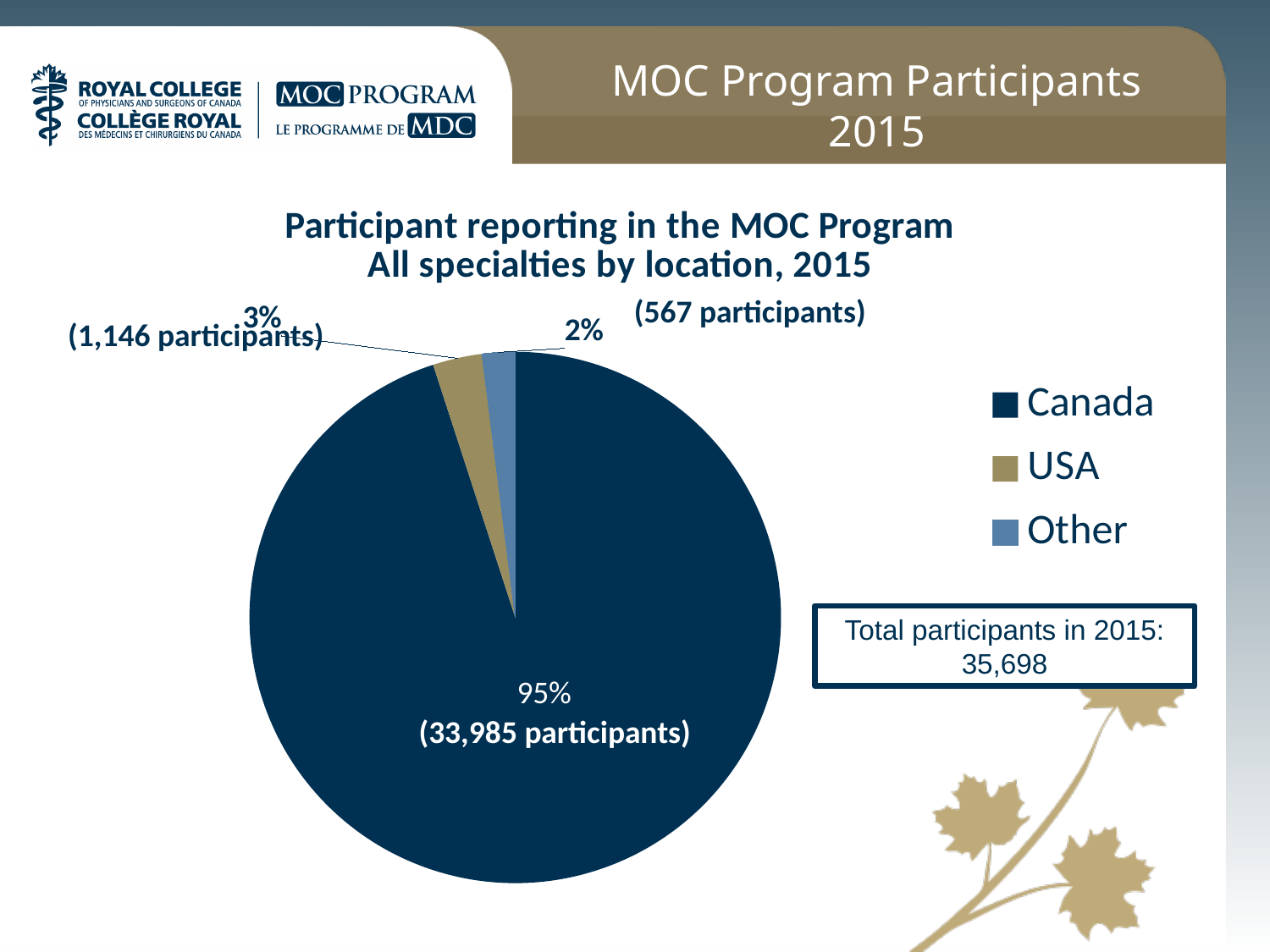
How many participants are reported for Canada? 33,985 participants How many participants are reported for Other? 567 participants What share of the pie does Other represent? 2% Which location has the smallest slice of the pie? Other What share of the pie does Canada represent? 95% What share of the pie does USA represent? 3% How many slices does the pie chart have? 3 What kind of chart is shown on the slide? pie chart What is the difference in participants between USA and Other? 579 How many participants are reported for USA? 1,146 participants Which location has the largest slice of the pie? Canada How many entries does the legend list? 3